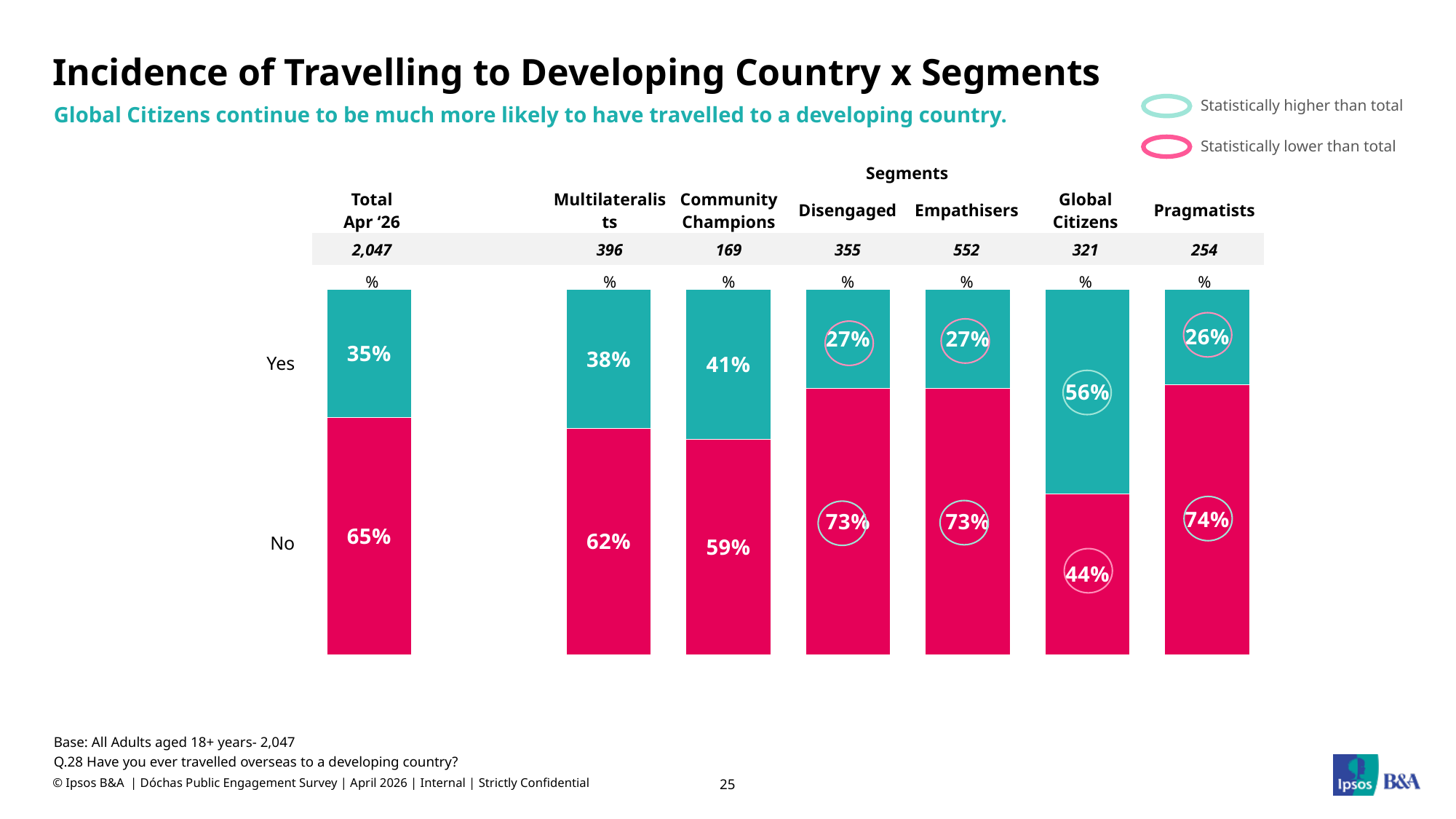
Which segment has the lowest Yes percentage? Pragmatists What percentage of the Total Apr '26 group answered Yes? 35% What is the difference in Yes percentage between Global Citizens and the Total Apr '26 group? 21 percentage points How many bars (groups) are shown in the chart? 7 What is the base size shown for the Empathisers segment? 552 What percentage of Community Champions answered Yes? 41% Which has a higher Yes percentage, Multilateralists or Community Champions? Community Champions Which segment has the highest Yes percentage? Global Citizens What percentage of Pragmatists answered No? 74% What type of chart is shown on the slide? Stacked bar chart What percentage of Global Citizens answered No? 44% What is the total of the Yes and No segments for the Disengaged bar? 100%